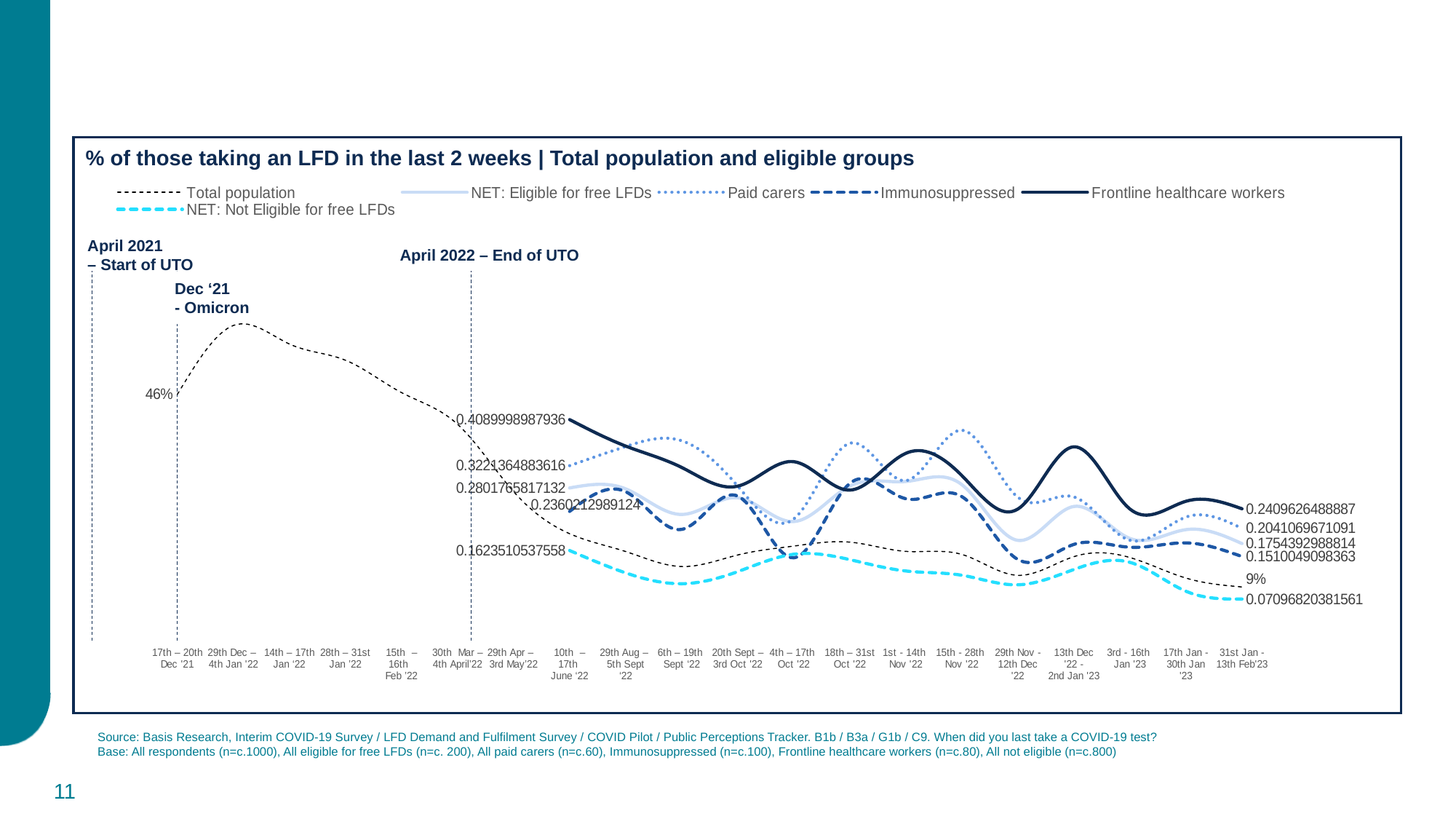
What is the value for Immunosuppressed at 31st Jan - 13th Feb '23? 0.1510049098363 What is the value for NET: Not Eligible for free LFDs at 31st Jan - 13th Feb '23? 0.07096820381561 At 10th – 17th June '22, which is larger: Paid carers or Immunosuppressed? Paid carers What kind of chart is shown on the slide? line chart Which event is annotated on the chart at Dec '21? Omicron What is the value for Total population at 17th – 20th Dec '21? 46% Which series has the highest value at 31st Jan - 13th Feb '23? Frontline healthcare workers What is the value for Total population at 31st Jan - 13th Feb '23? 9% Which series has the lowest value at 31st Jan - 13th Feb '23? NET: Not Eligible for free LFDs By how much does the Total population value fall from 17th – 20th Dec '21 to 31st Jan - 13th Feb '23? 37% How many series does the legend list? 6 What is the value for Frontline healthcare workers at 10th – 17th June '22? 0.4089998987936